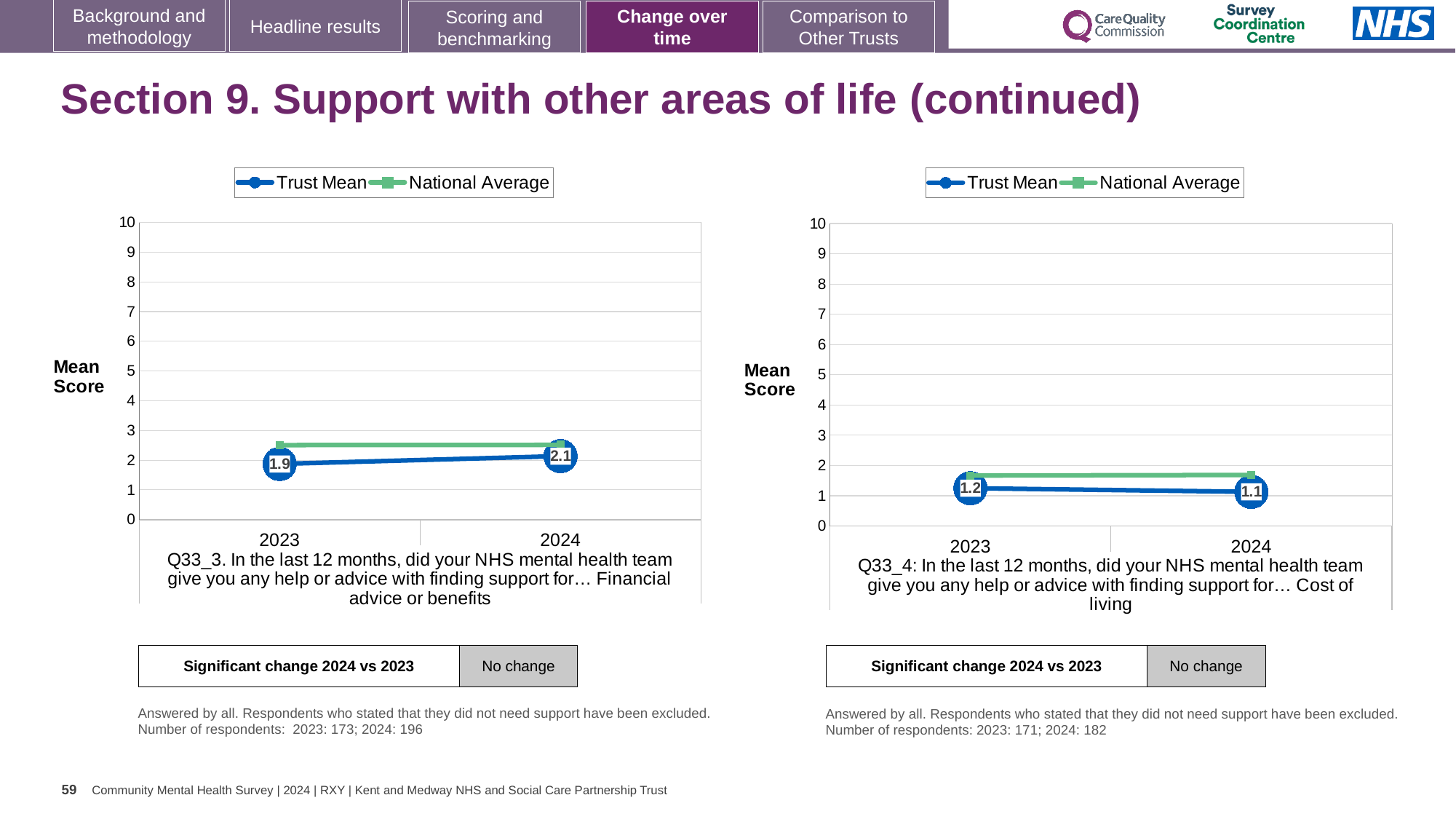
On the right chart (Q33_4, Cost of living), what is the Trust Mean for 2024? 1.1 On the right chart (Q33_4), does the Trust Mean rise or fall from 2023 to 2024? fall On the left chart (Q33_3), by how much did the Trust Mean change from 2023 to 2024? 0.2 How many series does the legend of the right chart (Q33_4) list? 2 On the left chart (Q33_3), does the Trust Mean rise or fall from 2023 to 2024? rise On the left chart (Q33_3), is the National Average value for 2024 greater or less than 3? less What kind of chart is used on the left of the slide (Q33_3)? line chart On the right chart (Q33_4, Cost of living), what is the Trust Mean for 2023? 1.2 On the left chart (Q33_3, Financial advice or benefits), what is the Trust Mean for 2023? 1.9 On the right chart (Q33_4), which year has the higher Trust Mean, 2023 or 2024? 2023 On the left chart (Q33_3, Financial advice or benefits), what is the Trust Mean for 2024? 2.1 On the right chart (Q33_4), is the National Average value for 2023 greater or less than 2? less